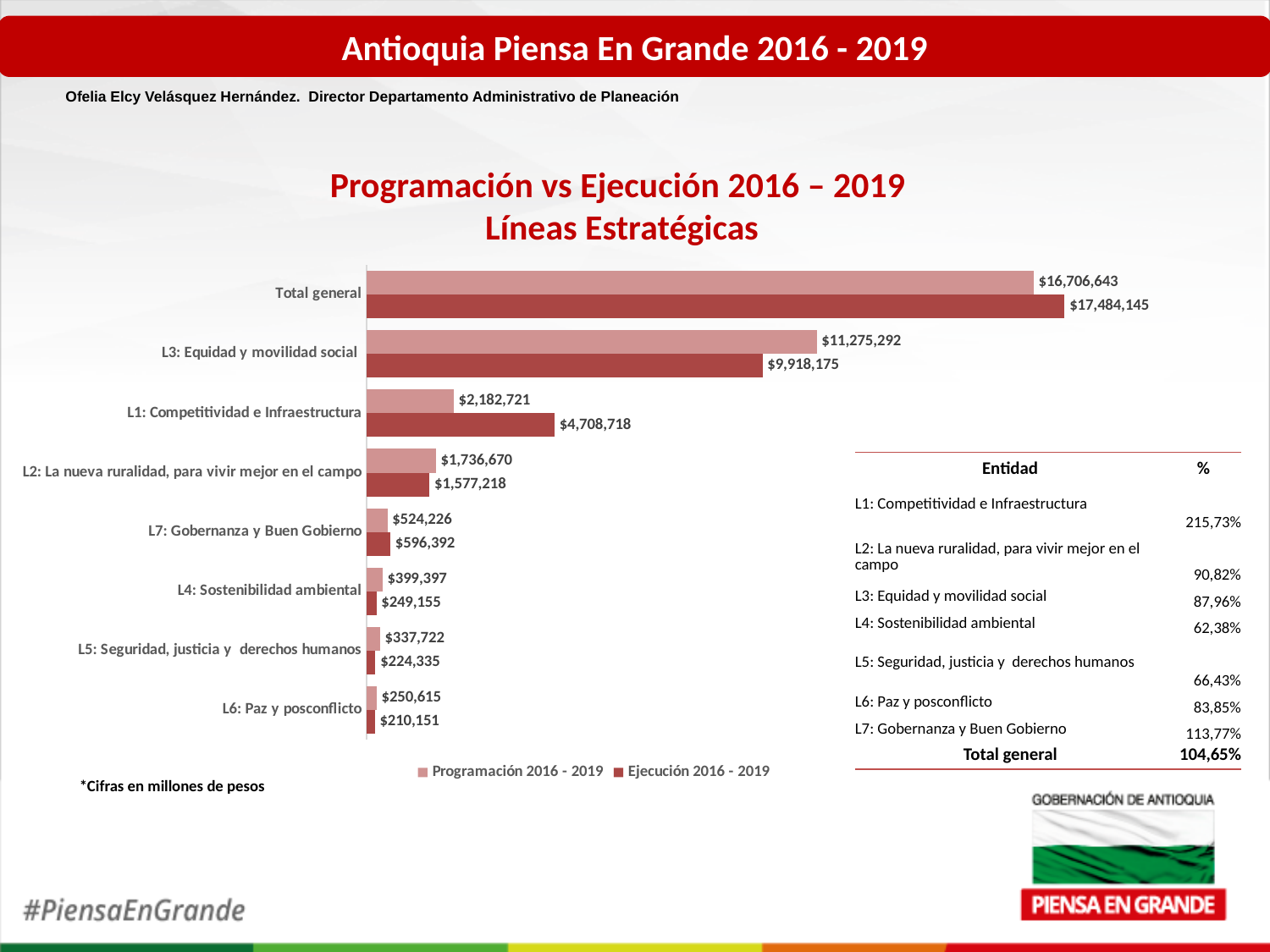
What kind of chart is shown on the slide? Bar chart How many series does the chart legend list? 2 Which series is shown in the darker red colour in the chart? Ejecución 2016 - 2019 What is the difference between the Ejecución and Programación values for L1: Competitividad e Infraestructura? $2,525,997 For L4: Sostenibilidad ambiental, which is larger, the Programación or the Ejecución value? Programación 2016 - 2019 What is the Ejecución 2016 - 2019 value for L6: Paz y posconflicto? $210,151 What is the Programación 2016 - 2019 value for L3: Equidad y movilidad social? $11,275,292 Which category has the lowest Ejecución 2016 - 2019 value? L6: Paz y posconflicto Excluding Total general, which category has the highest Programación 2016 - 2019 value? L3: Equidad y movilidad social What is the Ejecución 2016 - 2019 value for L1: Competitividad e Infraestructura? $4,708,718 What is the difference between the Programación and Ejecución values for L3: Equidad y movilidad social? $1,357,117 How many categories are plotted on the chart? 8